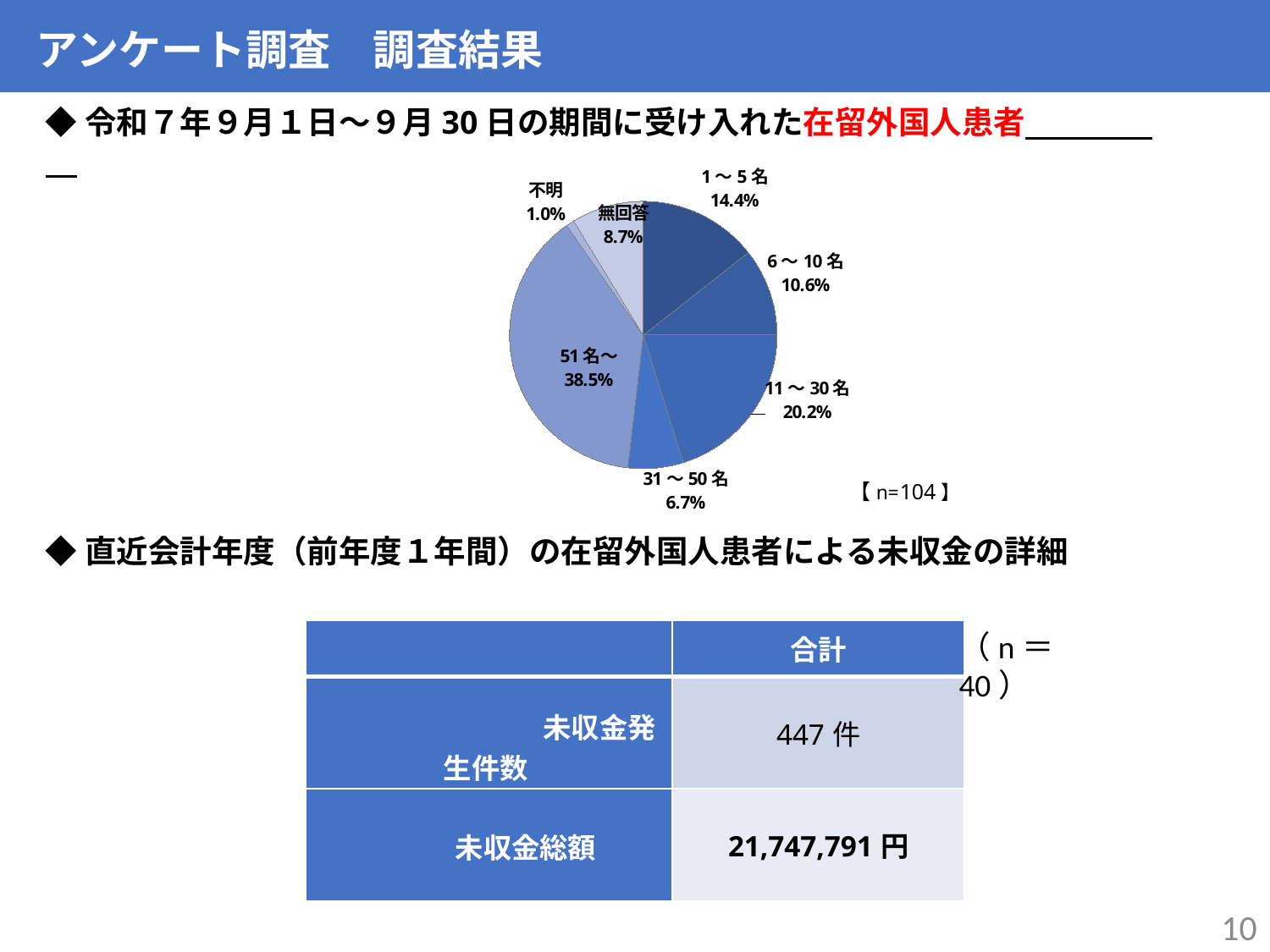
How many slices does the pie chart have? 7 What share of the pie chart is the 51名～ slice? 38.5% What kind of chart is shown on the slide? pie chart What share of the pie chart is the 無回答 slice? 8.7% What is the difference in percentage points between the 51名～ slice and the 11～30名 slice? 18.3 What share of the pie chart is the 1～5名 slice? 14.4% Which slice is larger in the pie chart, 6～10名 or 11～30名? 11～30名 Which category has the smallest slice in the pie chart? 不明 Which category has the largest slice in the pie chart? 51名～ What sample size (n) is shown next to the pie chart? n=104